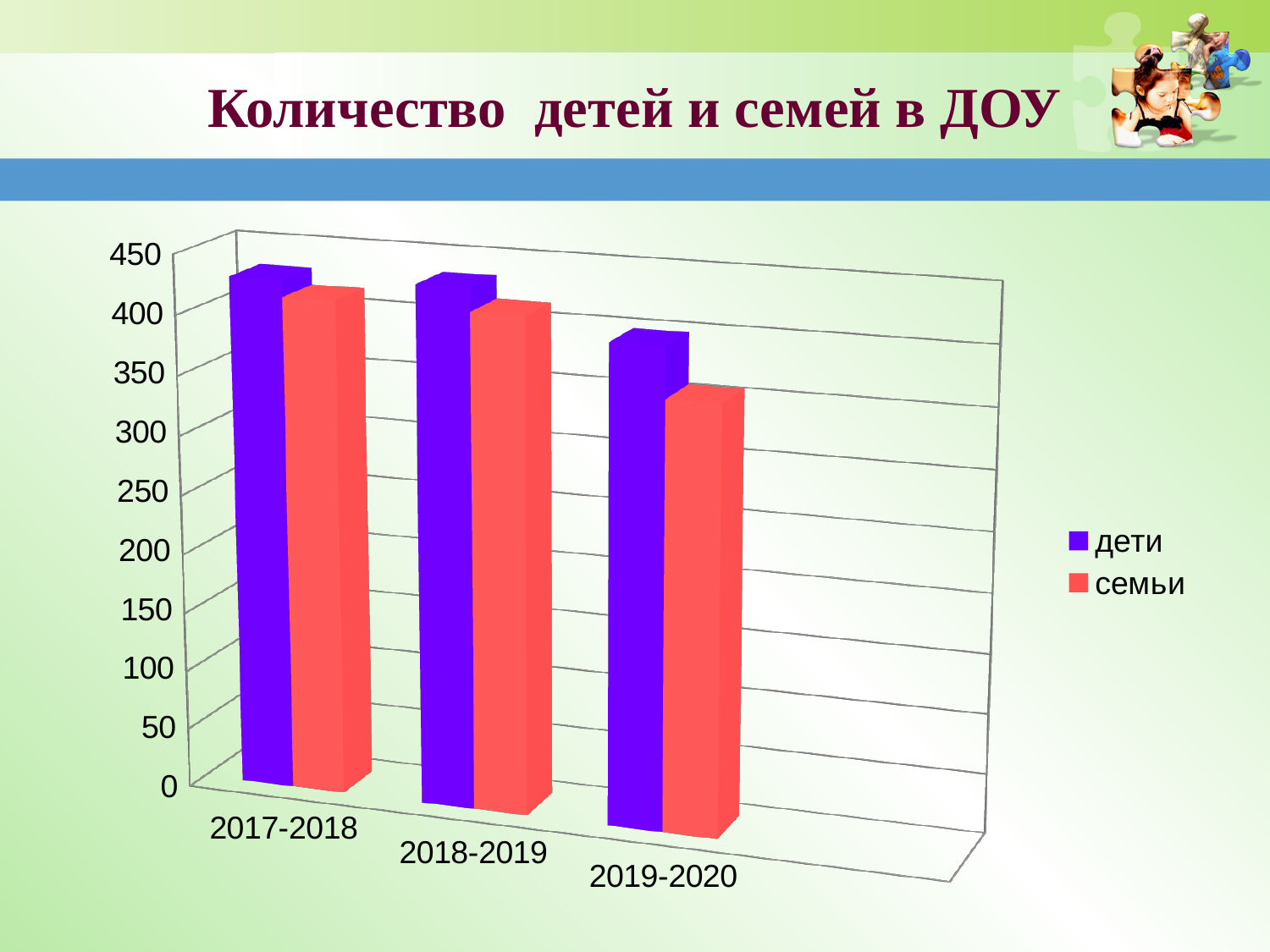
Is the value for дети in 2017-2018 greater or less than 400? greater What kind of chart is shown on the slide? bar chart What is the title of the chart? Количество детей и семей в ДОУ Is the value for дети in 2019-2020 greater or less than 350? greater Is the value for семьи in 2017-2018 greater or less than 350? greater How many categories (school years) are shown on the x axis? 3 Which series is shown in red? семьи In which year is the value for дети the lowest? 2019-2020 How many series does the legend list? 2 In which year is the value for семьи the lowest? 2019-2020 In 2019-2020, which is larger: дети or семьи? дети